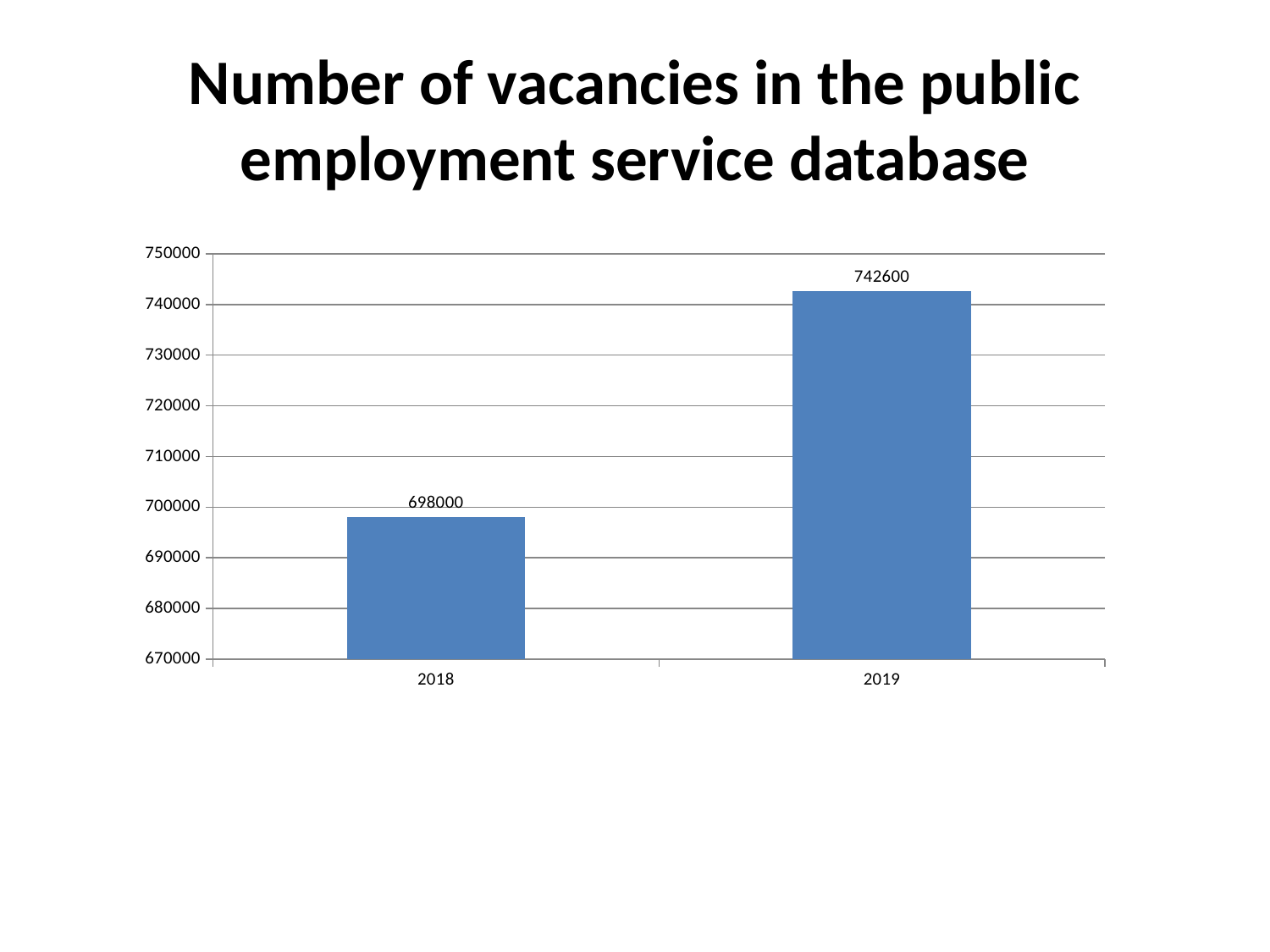
What kind of chart is shown on the slide? Bar chart Do the values rise or fall from 2018 to 2019? Rise How many years are shown on the x axis? 2 What is the number of vacancies for 2018? 698000 What is the title of the slide? Number of vacancies in the public employment service database What is the difference between the 2019 and 2018 values? 44600 Which year has the lower number of vacancies? 2018 Which year has the higher number of vacancies? 2019 Is the value for 2019 larger than the value for 2018? Yes Is the value for 2019 greater or less than 740000? greater What is the number of vacancies for 2019? 742600 Is the value for 2018 greater or less than 700000? less